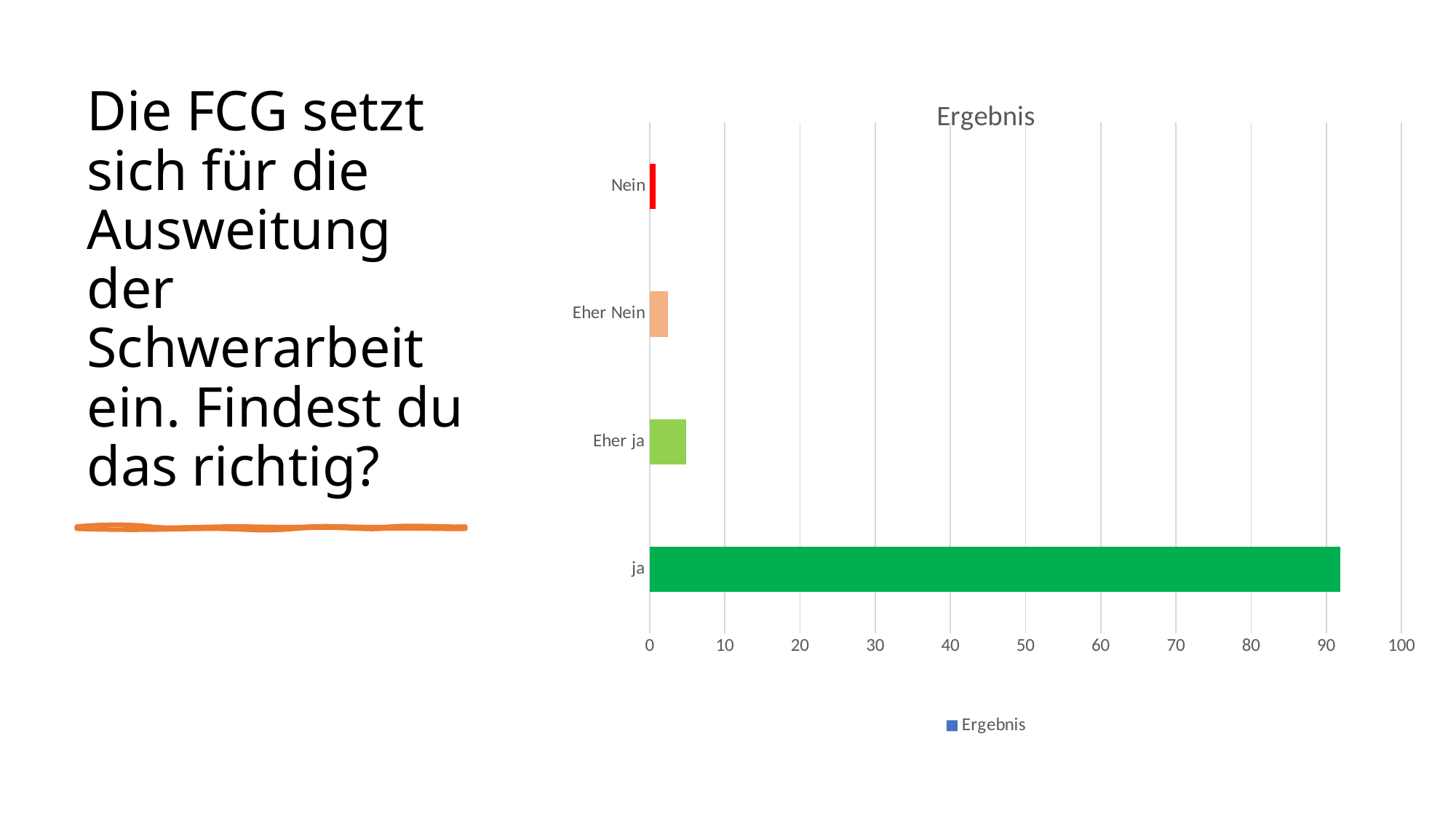
What is the name of the series shown in the legend? Ergebnis Is the value for Eher ja greater or less than 10? less Which is larger, the value for Eher ja or the value for Eher Nein? Eher ja What is the title of the chart? Ergebnis Is the value for Eher Nein greater or less than 10? less What kind of chart is shown on the slide? bar chart How many series does the legend list? 1 How many categories are shown in the chart? 4 Which is larger, the value for ja or the value for Eher ja? ja Which category has the highest value? ja Which category has the lowest value? Nein Is the value for ja greater or less than 90? greater